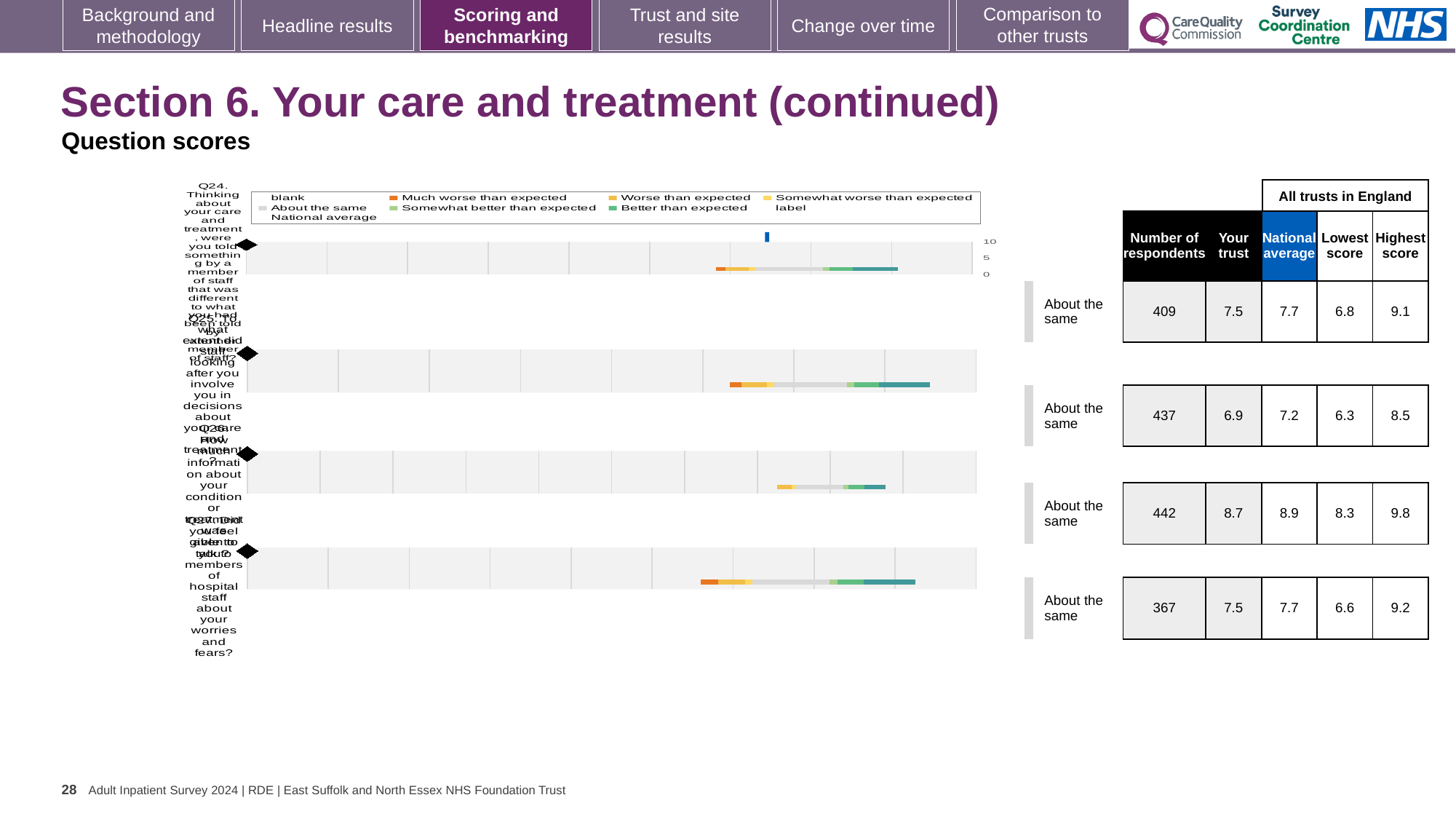
In the table beside the Q24 chart, what is the 'Your trust' score? 7.5 What benchmark category is shown next to each of the four charts? About the same What is the difference between the national average and the 'Your trust' score for Q25 in the table? 0.3 Which of the four questions (Q24 to Q27) has the lowest number of respondents in the table? Q27 How many question-score charts (Q24 to Q27) are shown on the slide? 4 What is the highest tick value shown on the horizontal axis of the top (Q24) chart? 10 In the table beside the Q26 chart, how many respondents are listed? 442 Which of the four questions (Q24 to Q27) has the highest 'Your trust' score in the table? Q26 In the table beside the Q25 chart, what is the national average score? 7.2 In the table beside the Q27 chart, what is the highest score among all trusts in England? 9.2 How many entries does the shared legend above the charts list? 9 What kind of chart is used for each of the question scores on this slide? bar chart